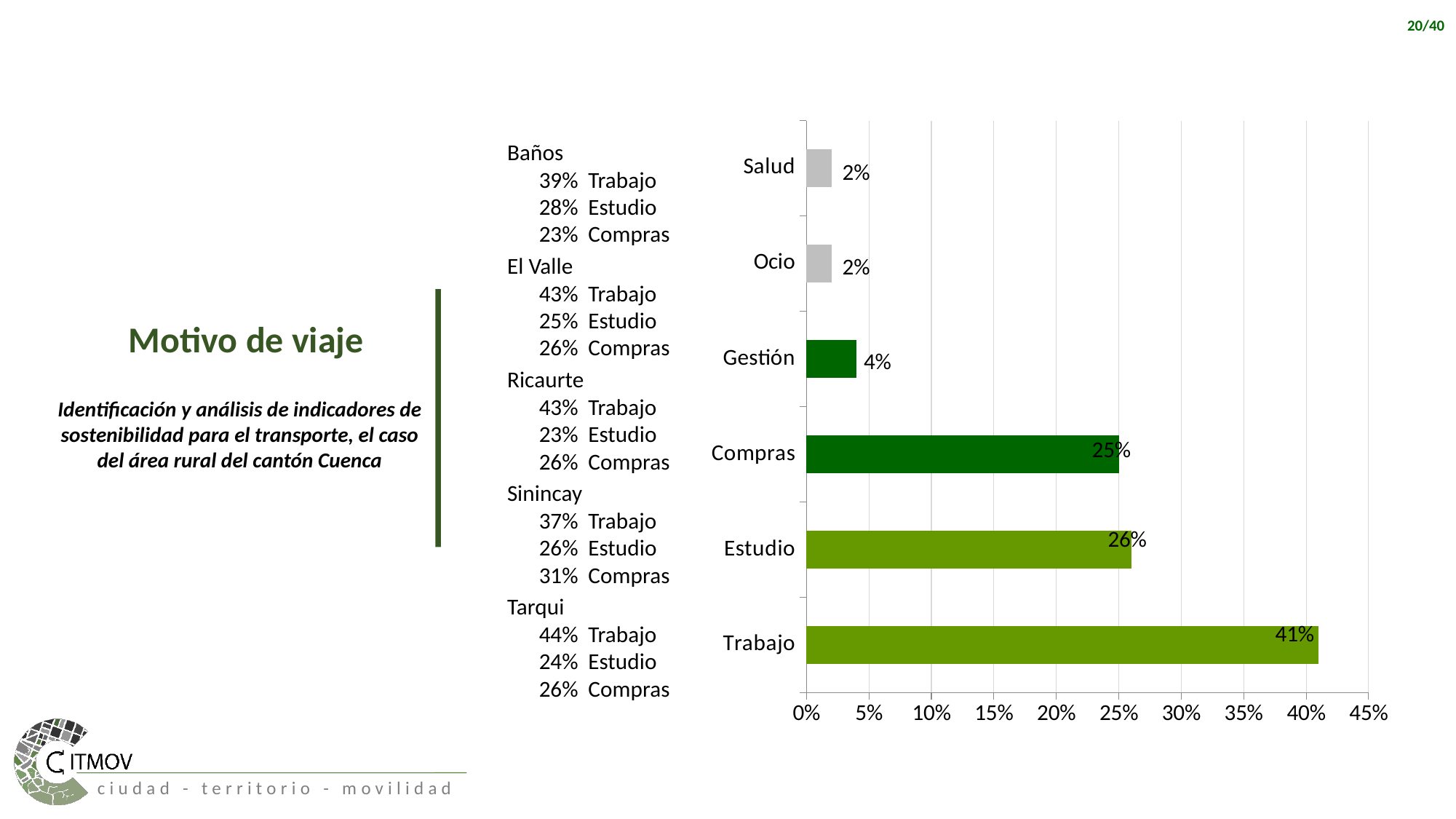
Which category has the highest value? Trabajo What is the title of the slide? Motivo de viaje How many categories are shown in the chart? 6 Which is larger, the value for Compras or the value for Gestión? Compras What is the difference between the values for Trabajo and Estudio? 15% What is the value for Compras? 25% What is the value for Gestión? 4% What is the value for Salud? 2% What is the difference between the values for Gestión and Ocio? 2% What is the value for Trabajo? 41% What kind of chart is shown on the slide? Bar chart Is the value for Trabajo greater or less than 40%? greater